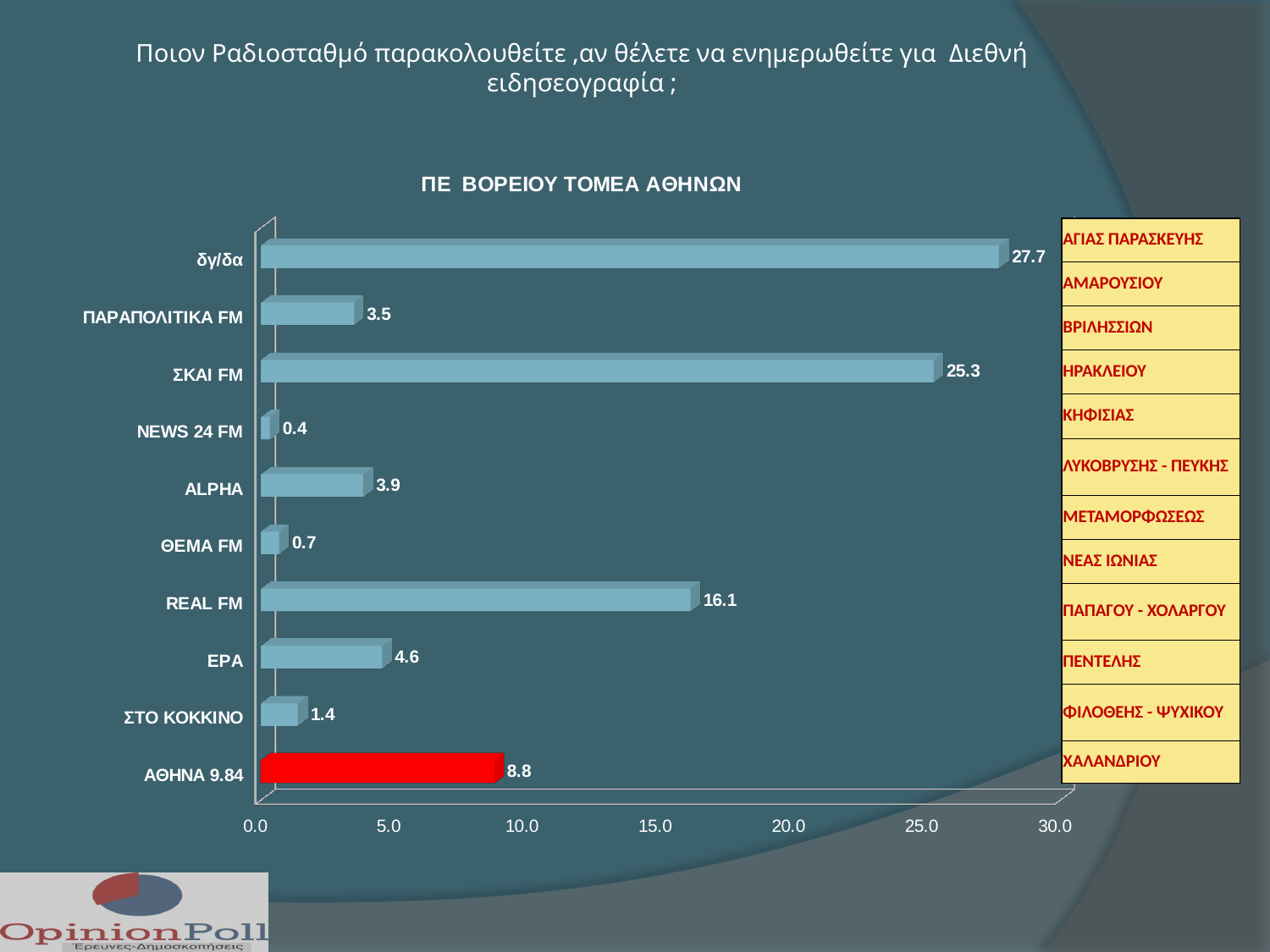
Is the value for ΣΚΑΙ FM greater or less than 20.0? greater What value is shown for ΣΚΑΙ FM? 25.3 What value is shown for NEWS 24 FM? 0.4 Which category has the lowest value? NEWS 24 FM Which category has the highest value? δγ/δα Which has a larger value, REAL FM or ΑΘΗΝΑ 9.84? REAL FM What type of chart is shown? Bar chart What value is shown for REAL FM? 16.1 What is the difference between the values for δγ/δα and ΣΚΑΙ FM? 2.4 What is the difference between the values for ΕΡΑ and ALPHA? 0.7 How many categories are shown in the chart? 10 What value is shown for ΑΘΗΝΑ 9.84? 8.8